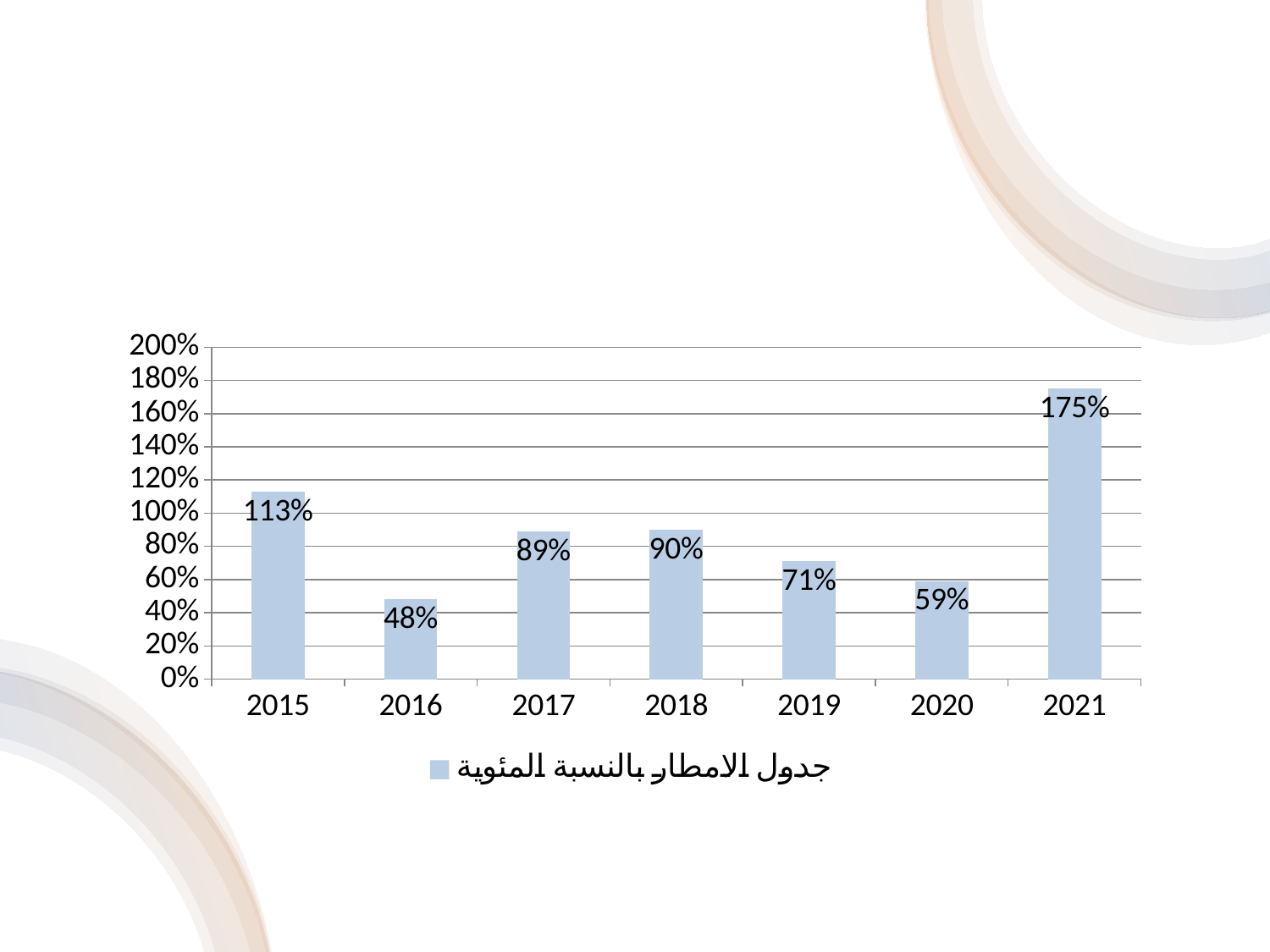
Which year has the highest value? 2021 What is the value for 2020? 59% What kind of chart is shown on the slide? bar chart What is the difference between the values for 2021 and 2016? 127% What is the value for 2019? 71% Which is larger, the value for 2017 or the value for 2019? 2017 What is the difference between the values for 2015 and 2020? 54% Is the value for 2018 greater or less than 100%? less Which year has the lowest value? 2016 How many years are shown on the x axis? 7 How many series does the legend list? 1 What is the value for 2015? 113%